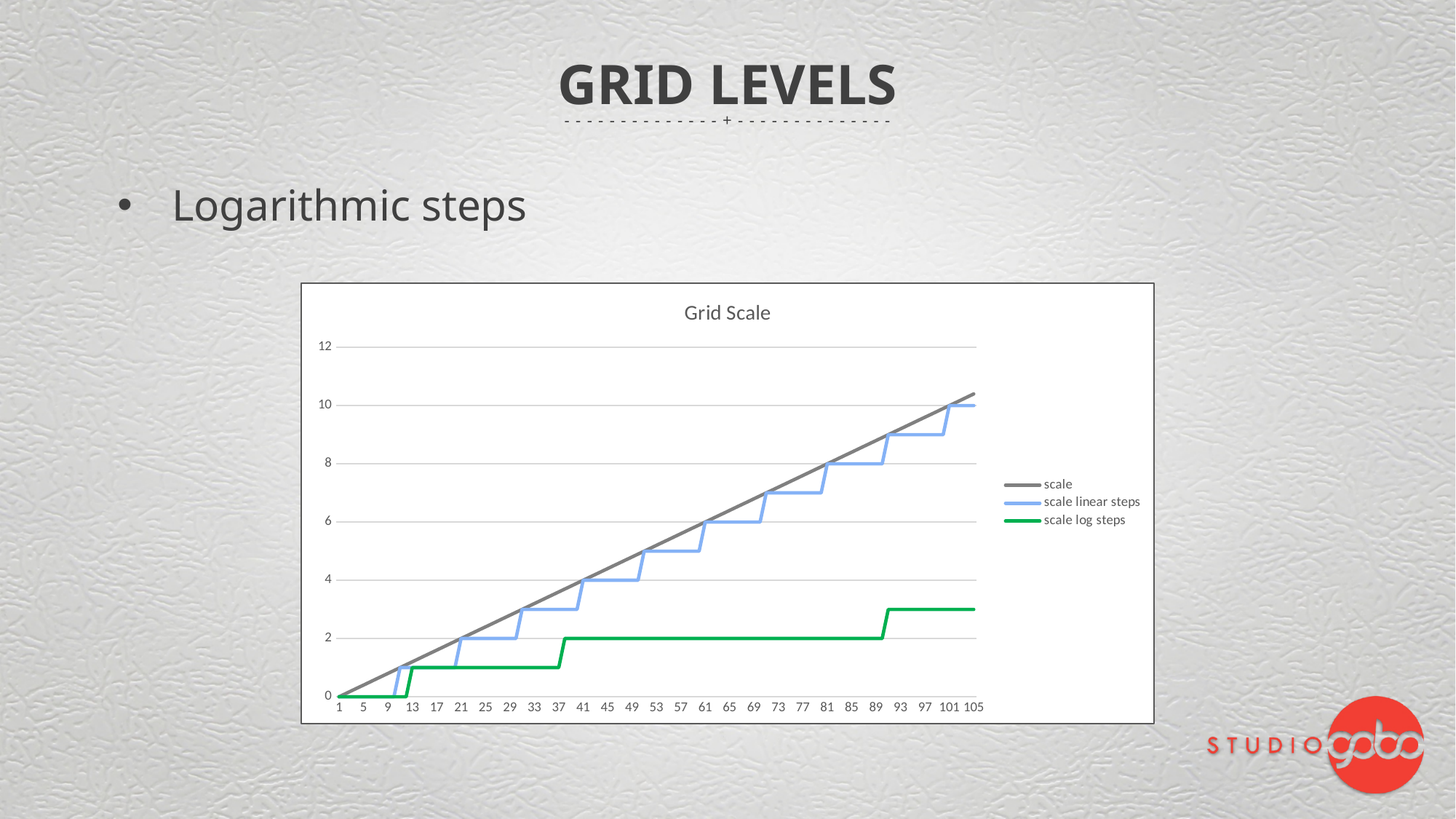
What is the title of the chart? Grid Scale Which series is drawn in green? scale log steps What is the value of the scale log steps series at x = 65? 2 Is the value of the scale log steps series at x = 105 greater or less than 4? less At x = 105, which is larger: scale linear steps or scale log steps? scale linear steps What kind of chart is shown on the slide? line chart What is the value of the scale linear steps series at x = 65? 6 Which series has the highest value at x = 105? scale How many series does the chart's legend list? 3 Is the value of the scale series at x = 53 greater or less than 4? greater Does the scale series rise or fall as x increases? rise What is the value of the scale linear steps series at x = 105? 10